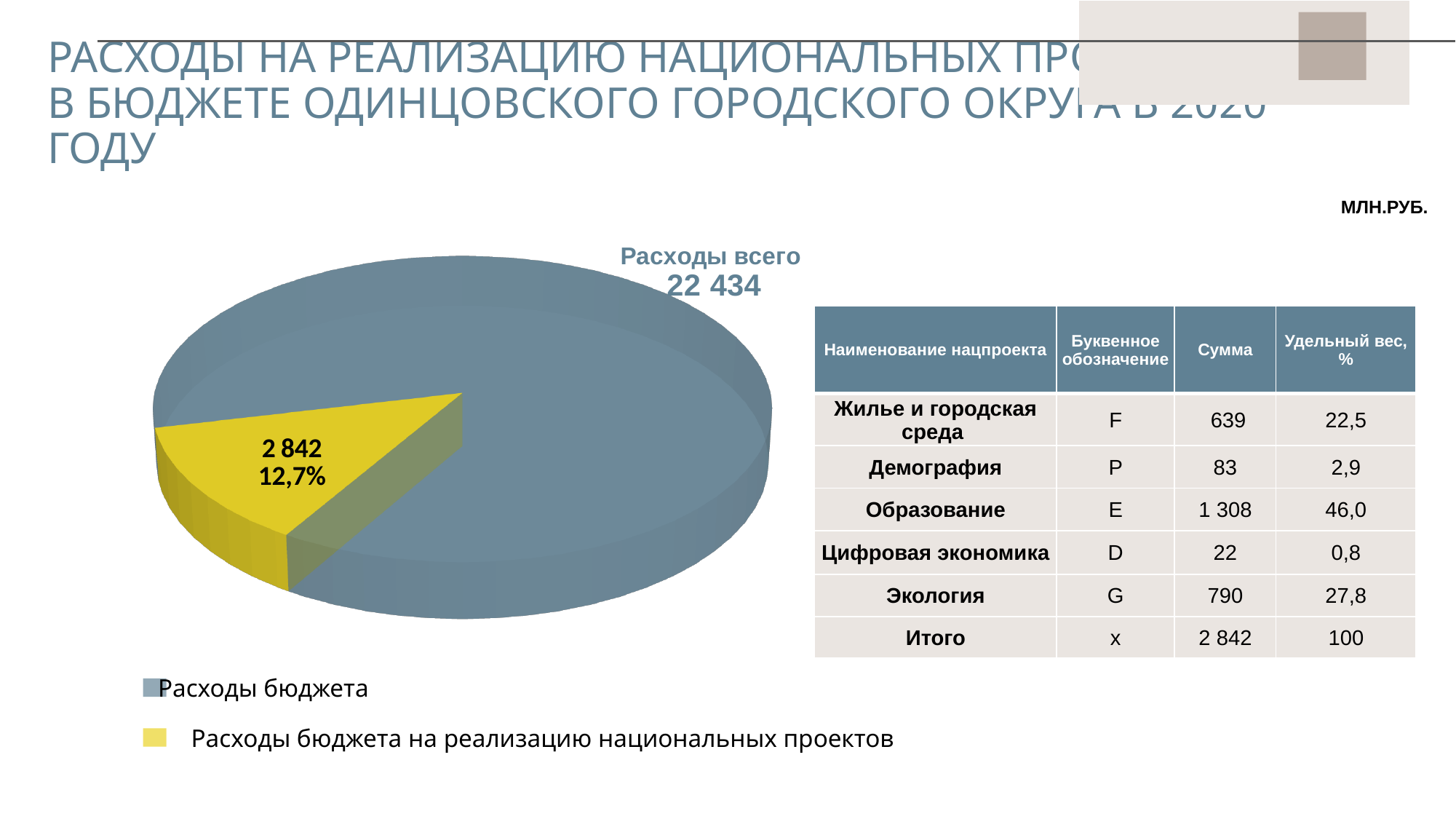
In what units are the values on the slide expressed, according to the label in the top right? МЛН.РУБ. What value is labelled on the yellow slice of the pie chart? 2 842 How many entries does the legend of the pie chart list? 2 What kind of chart is shown on the slide? pie chart Which is larger in the pie chart: 'Расходы бюджета' or 'Расходы бюджета на реализацию национальных проектов'? Расходы бюджета What share of the pie does the slice for 'Расходы бюджета на реализацию национальных проектов' represent? 12,7% Which slice of the pie chart is the smallest? Расходы бюджета на реализацию национальных проектов What is the value shown for 'Расходы всего' on the pie chart? 22 434 What is the difference between 'Расходы всего' (22 434) and the value of the national projects slice (2 842)? 19 592 What colour is the slice for 'Расходы бюджета на реализацию национальных проектов' in the pie chart? yellow How many slices does the pie chart have? 2 Which slice of the pie chart is the largest? Расходы бюджета